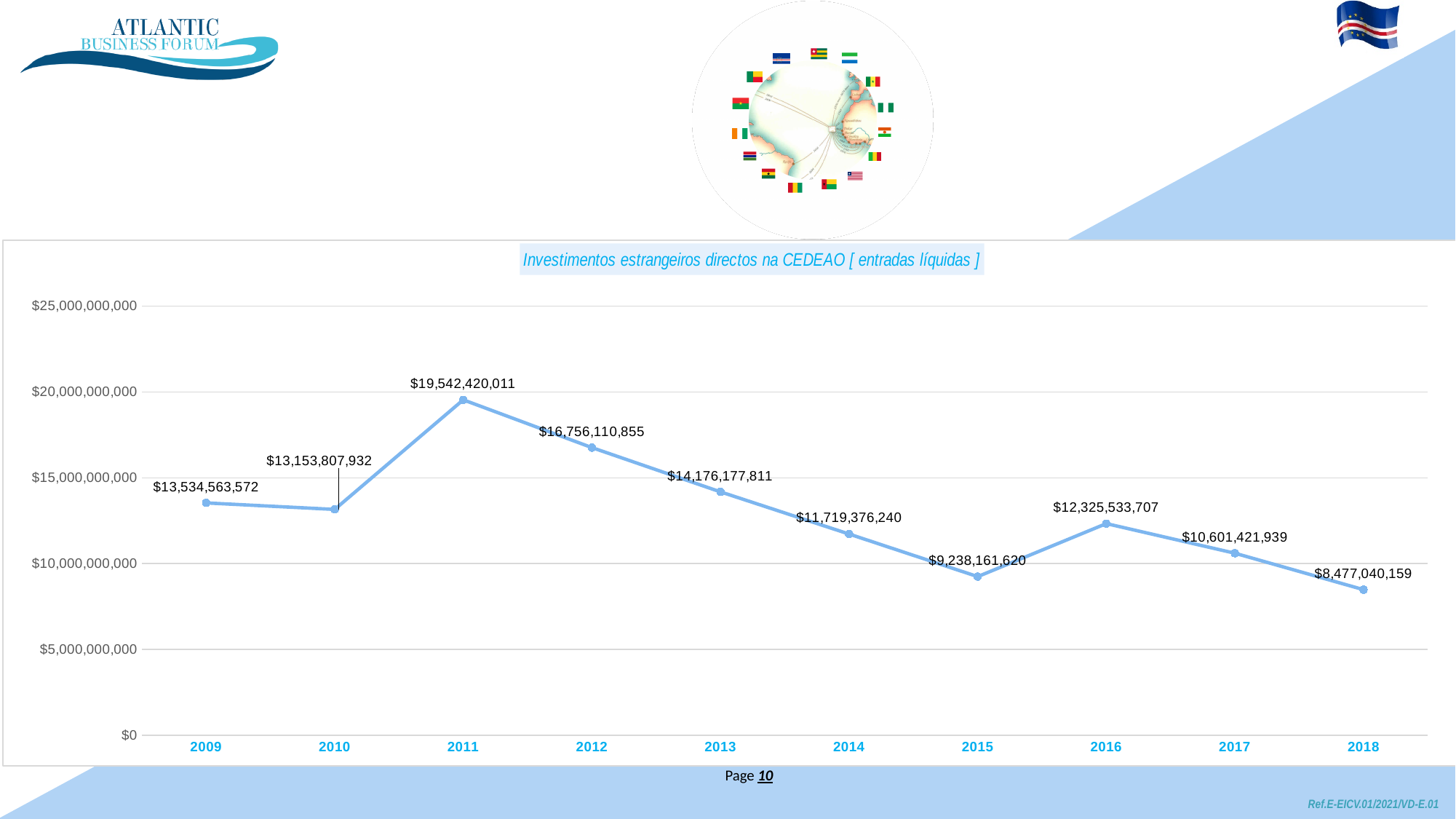
What is the difference between the values for 2009 and 2010? $380,755,640 What is the title of the chart? Investimentos estrangeiros directos na CEDEAO [ entradas líquidas ] Is the value for 2014 greater or less than $10,000,000,000? greater What is the difference between the values for 2011 and 2018? $11,065,379,852 Which year has the lowest value? 2018 Which is larger, the value for 2012 or the value for 2016? 2012 What is the value for 2011? $19,542,420,011 What is the value for 2018? $8,477,040,159 Which year has the highest value? 2011 How many years are plotted on the x axis? 10 What type of chart is shown on the slide? Line chart What is the value for 2015? $9,238,161,620